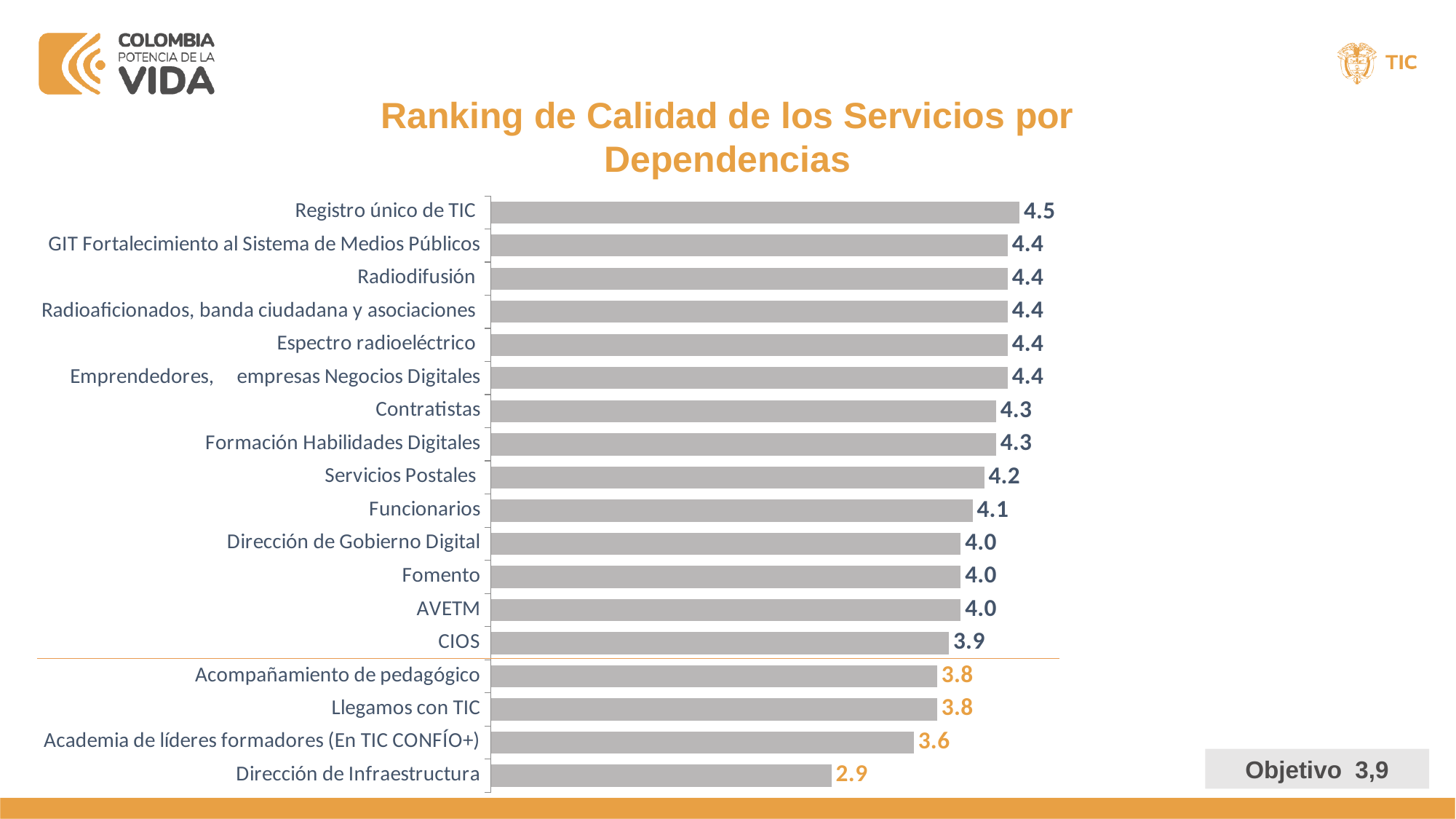
What kind of chart is shown on the slide? Bar chart Which is larger, the value for Contratistas or the value for Llegamos con TIC? Contratistas How many categories are shown in the chart? 18 What is the value for Registro único de TIC? 4.5 What is the value for Servicios Postales? 4.2 Which category has the highest value? Registro único de TIC Which category has the lowest value? Dirección de Infraestructura What is the difference between the values for Funcionarios and CIOS? 0.2 What is the value for Academia de líderes formadores (En TIC CONFÍO+)? 3.6 What is the title of the chart? Ranking de Calidad de los Servicios por Dependencias What is the difference between the values for Registro único de TIC and Dirección de Infraestructura? 1.6 What is the value for Dirección de Infraestructura? 2.9